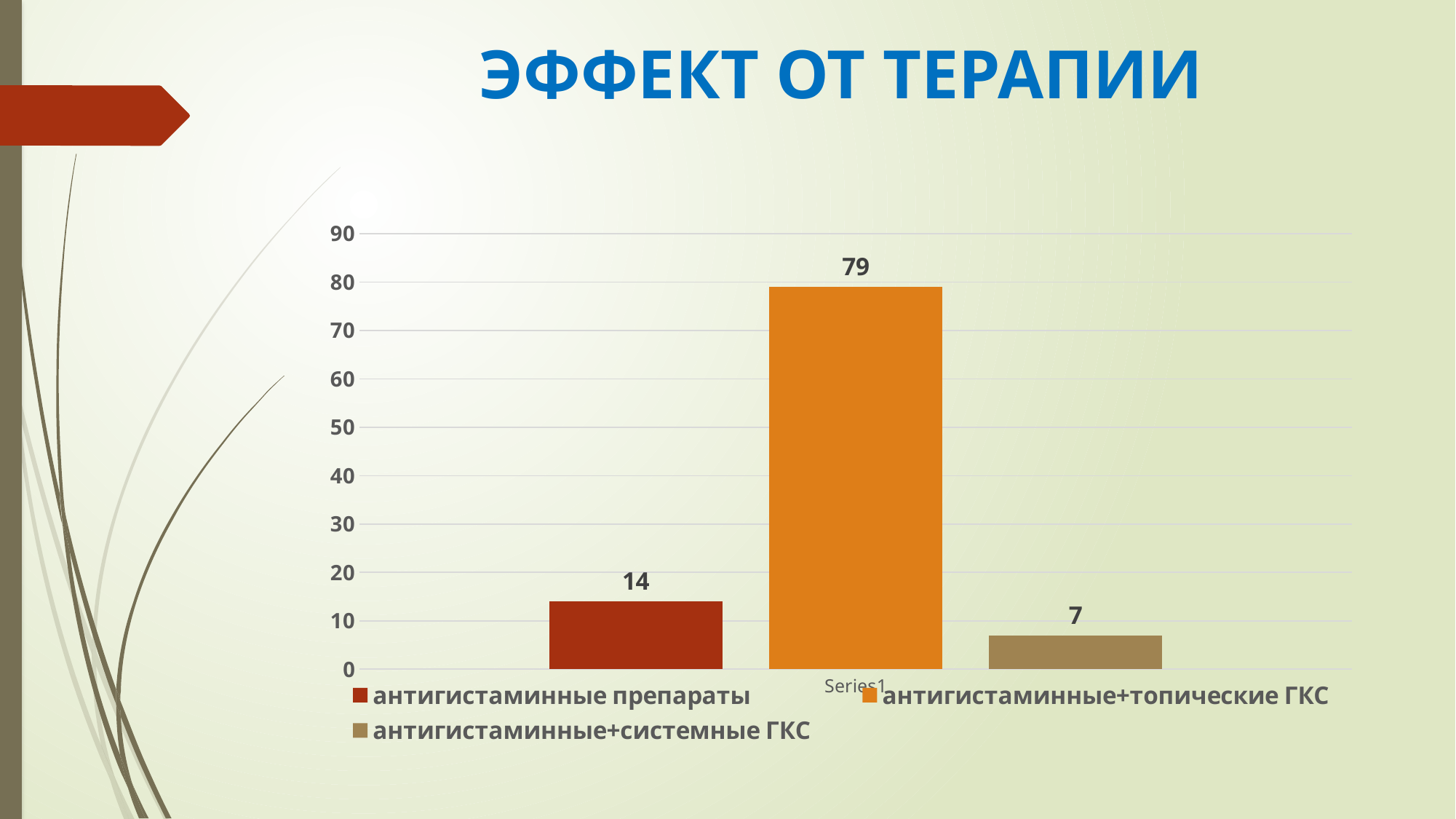
What is the value for антигистаминные+системные ГКС? 7 What is the difference between the values for антигистаминные препараты and антигистаминные+системные ГКС? 7 What is the value for антигистаминные препараты? 14 What kind of chart is shown on the slide? bar chart What is the value for антигистаминные+топические ГКС? 79 Which is larger: the value for антигистаминные препараты or for антигистаминные+системные ГКС? антигистаминные препараты What is the title of the slide? ЭФФЕКТ ОТ ТЕРАПИИ What is the difference between the values for антигистаминные+топические ГКС and антигистаминные препараты? 65 Which series has the lowest value? антигистаминные+системные ГКС How many series does the legend list? 3 Which series has the highest value? антигистаминные+топические ГКС Is the value for антигистаминные+топические ГКС greater or less than 70? greater